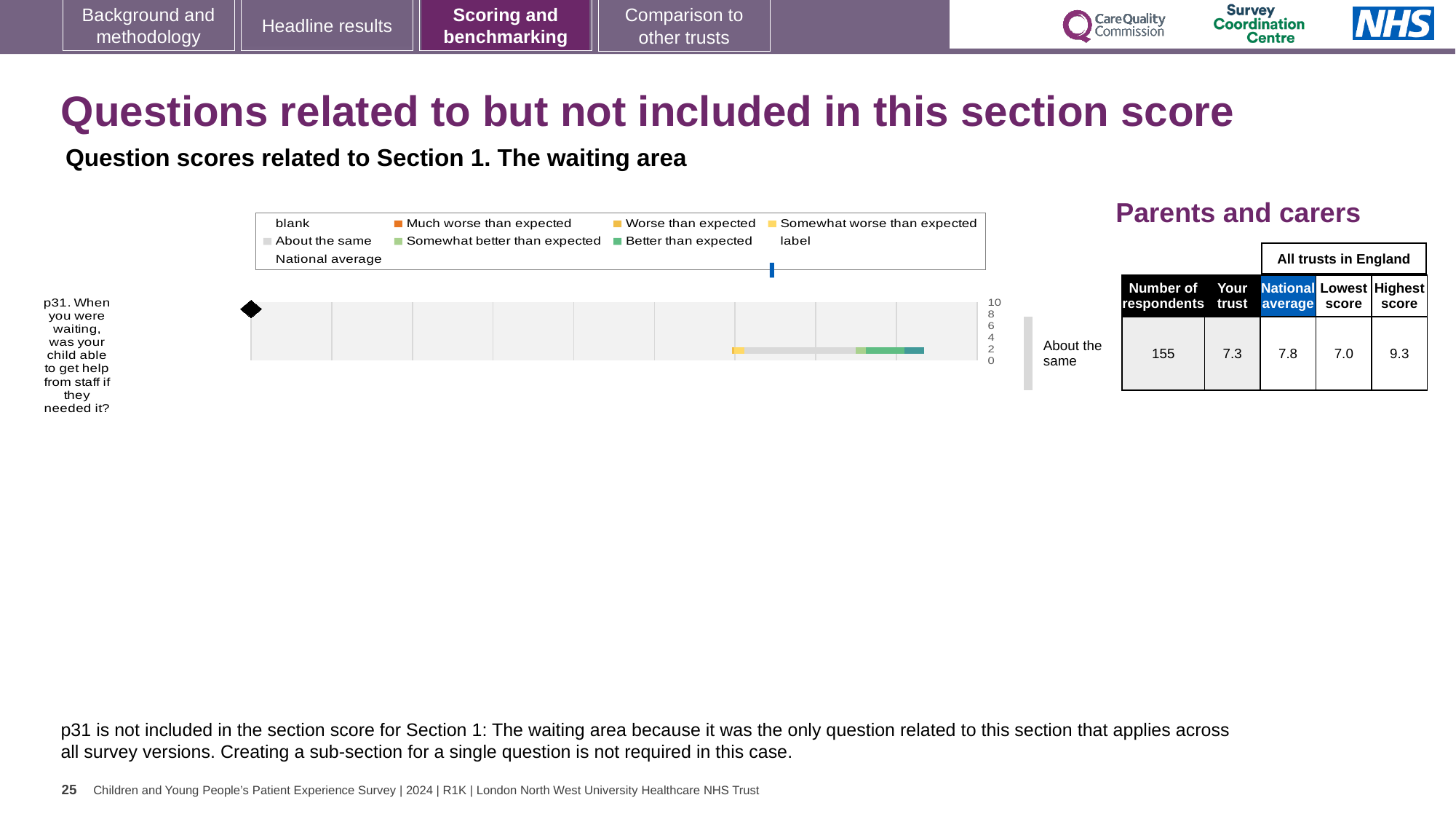
What kind of chart is shown for question p31? bar chart How many questions (categories) are plotted in the chart? 1 In the table beside the chart, what is the national average score for p31? 7.8 Using the table beside the chart, which is larger for p31: the 'Your trust' score or the national average? National average In the table beside the chart, what is the 'Your trust' score for p31? 7.3 Which legend entry is shown in orange? Much worse than expected In the table beside the chart, what is the number of respondents for p31? 155 In the table beside the chart, what is the highest score among all trusts in England for p31? 9.3 In the table beside the chart, what is the lowest score among all trusts in England for p31? 7.0 What benchmark category is shown next to the p31 bar? About the same What is the highest value shown on the chart's axis? 10 How many entries does the chart's legend list? 9